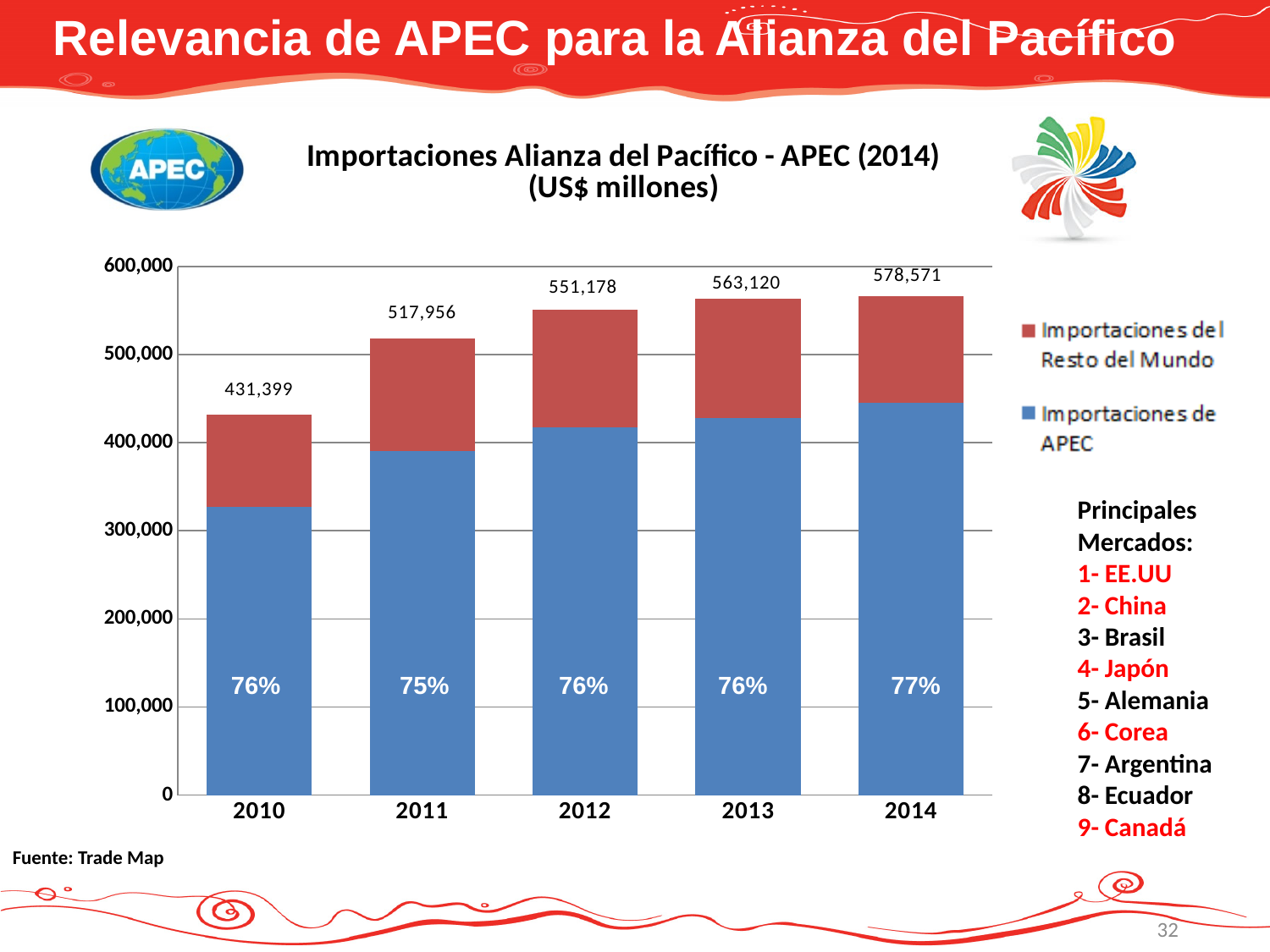
How many years are shown on the x axis? 5 Which is larger, the total for 2011 or the total for 2012? 2012 Which year has the lowest total imports? 2010 What is the total value of the bar for 2014? 578,571 How many series does the legend list? 2 What is the total value of the bar for 2010? 431,399 Is the value of Importaciones de APEC for 2010 greater or less than 300,000? greater Which year has the highest total imports? 2014 What is the difference between the total for 2014 and the total for 2013? 15,451 What percentage is shown inside the APEC portion of the 2011 bar? 75% What percentage is shown inside the APEC portion of the 2014 bar? 77% Do the total imports rise or fall from 2010 to 2014? rise